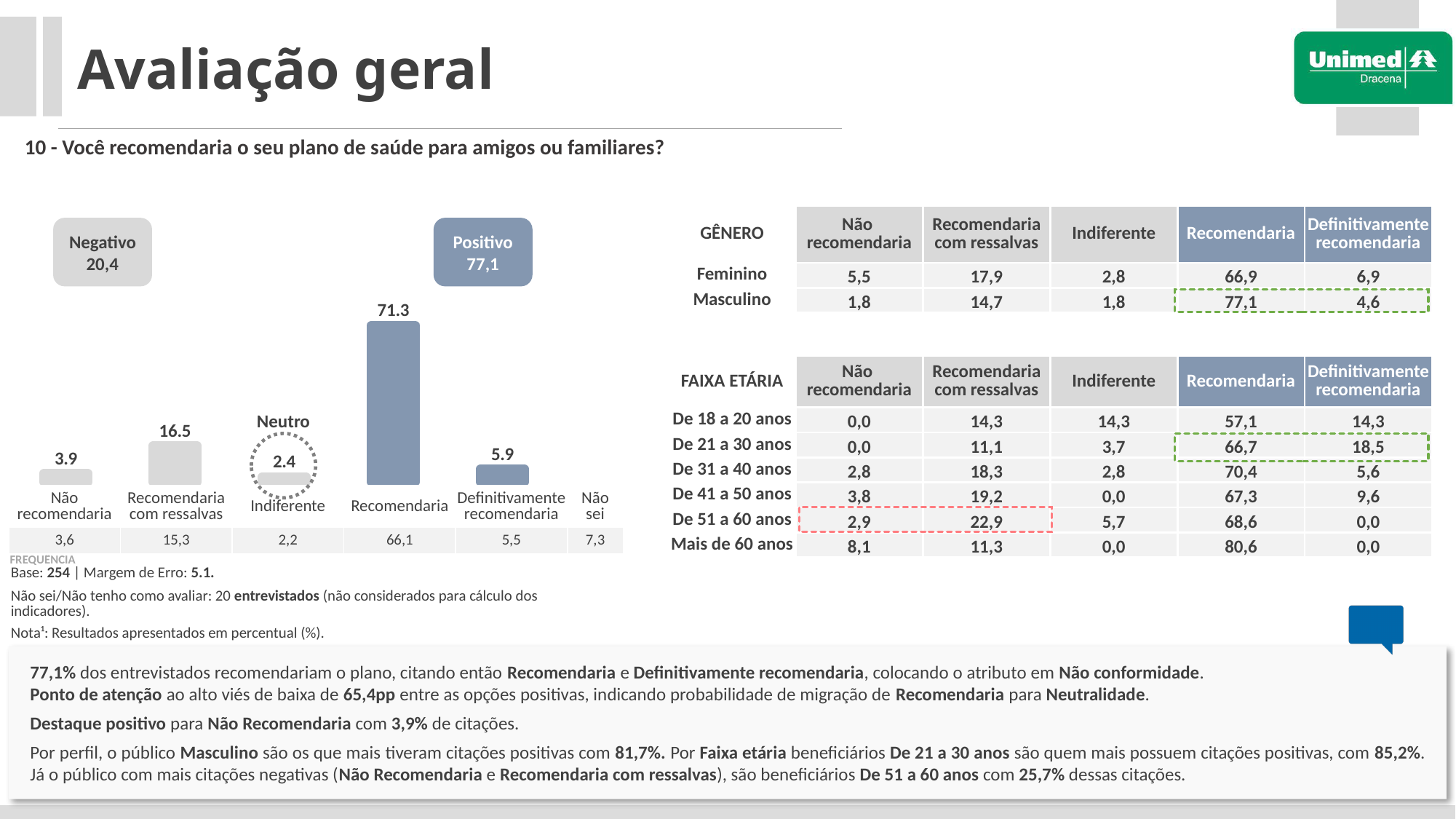
What is the value shown for the Não recomendaria bar in the chart? 3.9 Which category has the highest bar in the chart? Recomendaria How many bars are plotted in the chart? 5 What is the value shown for the Recomendaria com ressalvas bar? 16.5 What is the value shown for the Definitivamente recomendaria bar? 5.9 What kind of chart is shown on the slide? Bar chart What is the value shown for the Recomendaria bar in the chart? 71.3 What value is shown in the Positivo box above the chart? 77,1 What is the value shown for the Indiferente bar? 2.4 Which category has the lowest bar in the chart? Indiferente What is the difference between the Recomendaria bar and the Recomendaria com ressalvas bar? 54.8 Which is larger, the Definitivamente recomendaria bar or the Não recomendaria bar? Definitivamente recomendaria